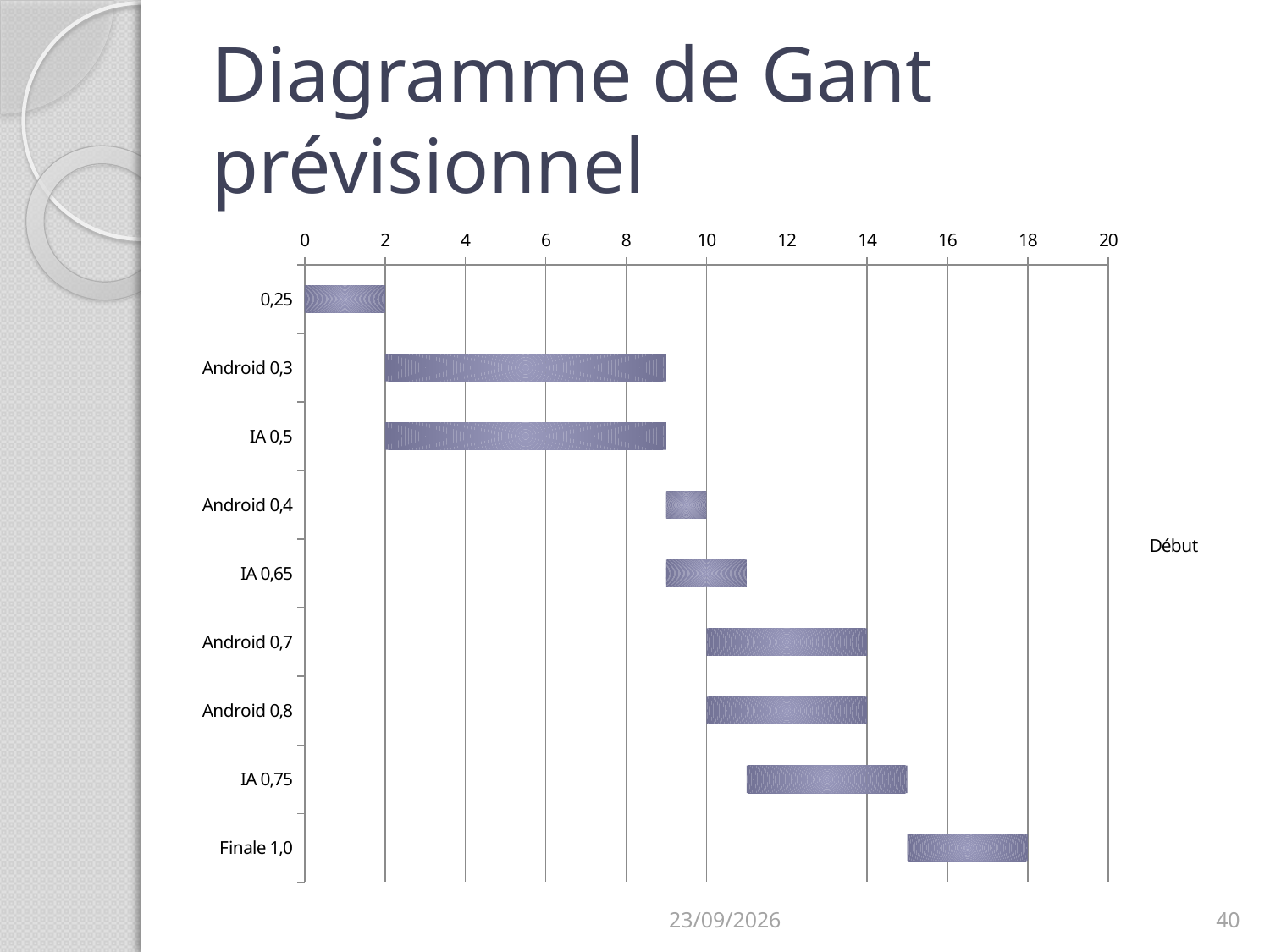
Which task's bar extends furthest to the right on the chart? Finale 1,0 At which value on the horizontal axis does the bar for 0,25 end? 2 How many series does the chart legend list? 1 At which value on the horizontal axis does the bar for Android 0,7 start? 10 Is the end of the bar for IA 0,75 greater or less than 14? greater How many categories (tasks) are listed on the vertical axis of the chart? 9 What is the title of the slide containing the chart? Diagramme de Gant prévisionnel Which task has the shortest bar on the chart? Android 0,4 What kind of chart is shown on the slide? bar chart What is the legend entry shown on the chart? Début Which bar starts later on the horizontal axis, Finale 1,0 or IA 0,75? Finale 1,0 At which value on the horizontal axis does the bar for Finale 1,0 end? 18